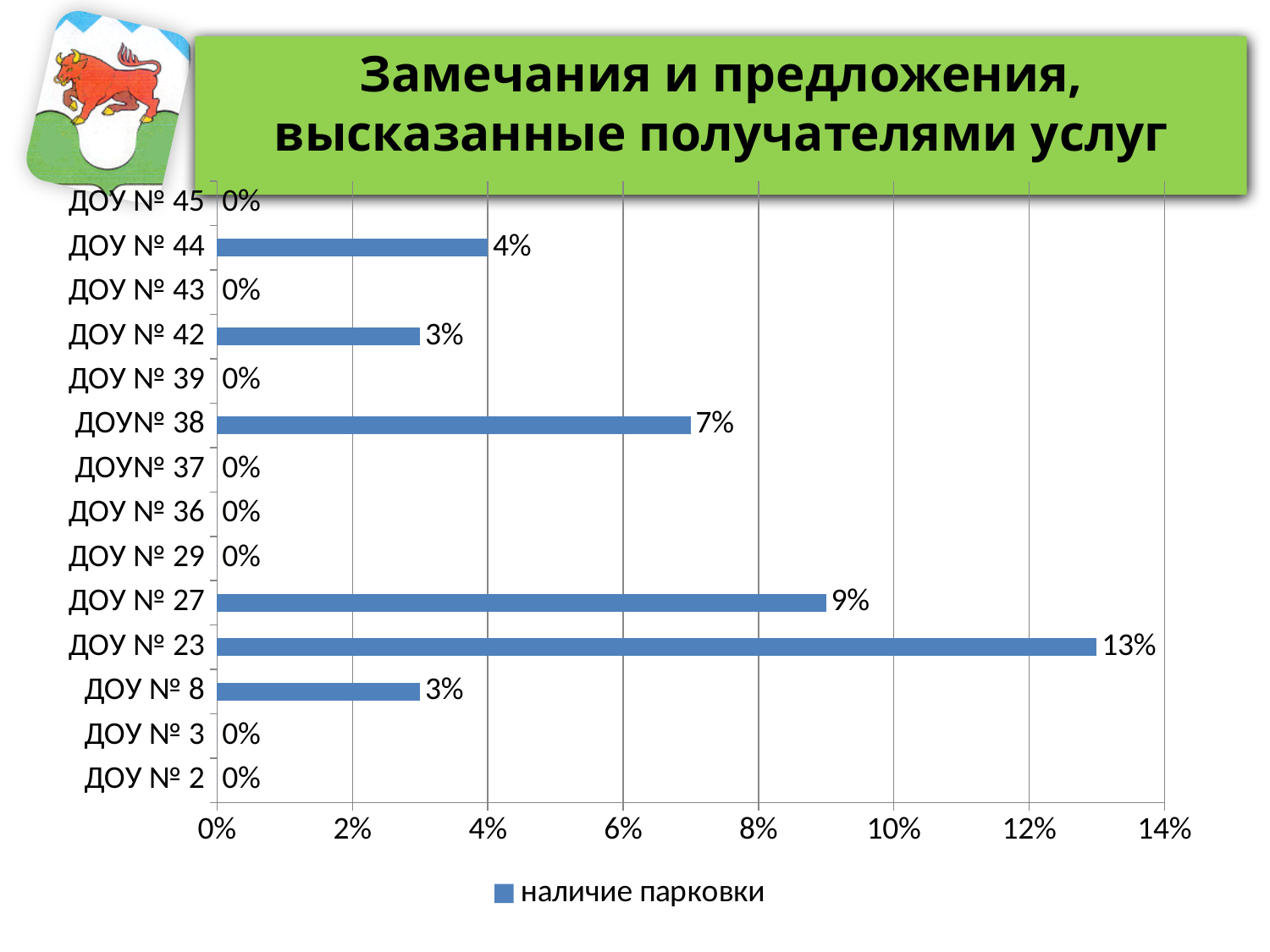
How many categories are shown on the chart? 14 Which is larger, the value for ДОУ № 27 or the value for ДОУ № 44? ДОУ № 27 What kind of chart is shown on the slide? bar chart What value is shown for ДОУ № 38? 7% What value is shown for ДОУ № 44? 4% What value is shown for ДОУ № 23? 13% What is the name of the series shown in the legend? наличие парковки Is the value for ДОУ № 23 greater or less than 12%? greater What is the difference between the values for ДОУ № 23 and ДОУ № 27? 4% What is the difference between the values for ДОУ № 38 and ДОУ № 42? 4% How many series does the legend list? 1 Which category has the highest value? ДОУ № 23